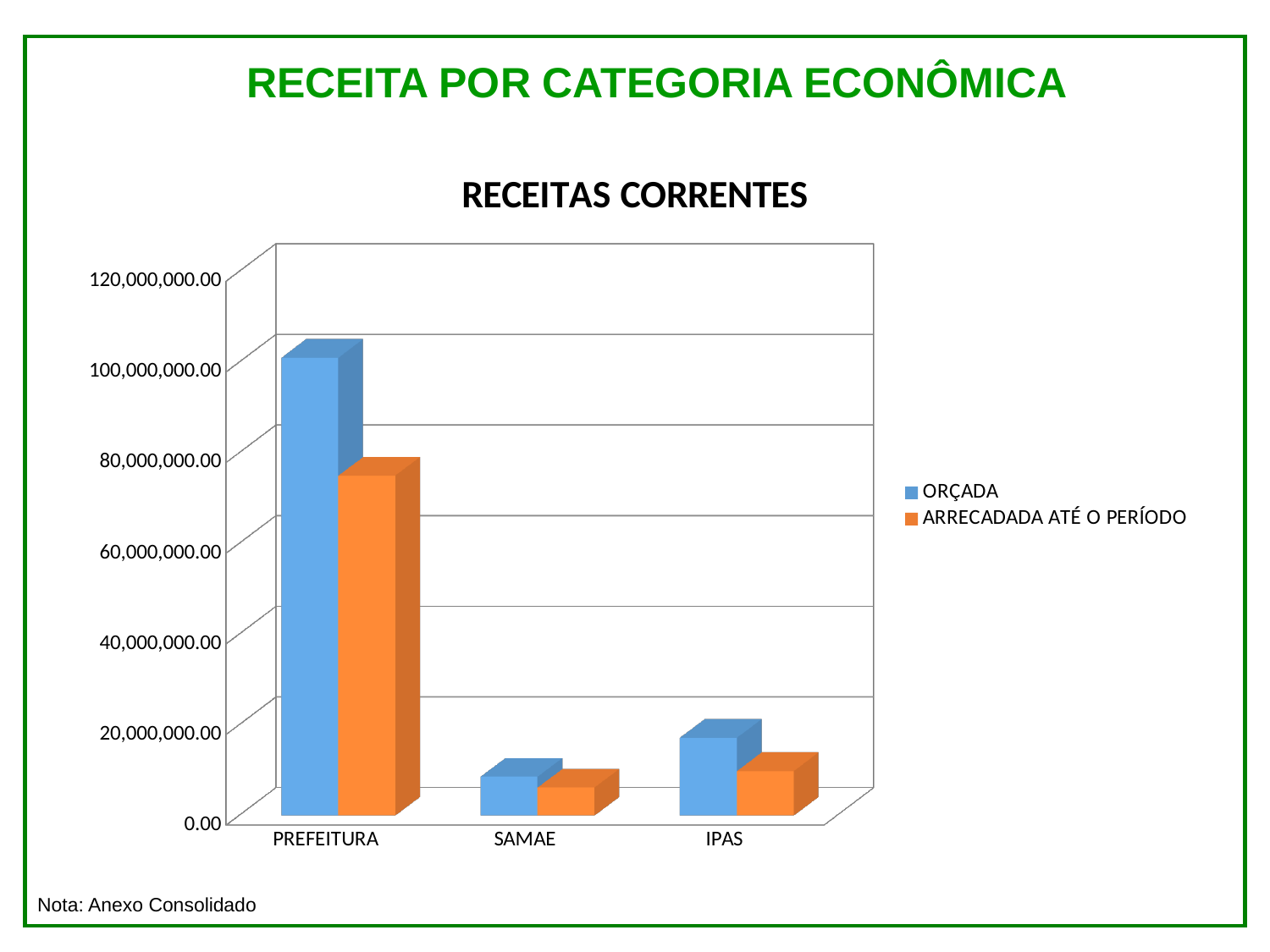
Which category has the highest ORÇADA value? PREFEITURA What kind of chart is shown on the slide? bar chart Is the ORÇADA value for PREFEITURA greater or less than 80,000,000.00? greater For PREFEITURA, which is larger: ORÇADA or ARRECADADA ATÉ O PERÍODO? ORÇADA Which has the larger ORÇADA value: SAMAE or IPAS? IPAS Which category has the lowest ARRECADADA ATÉ O PERÍODO value? SAMAE Is the ARRECADADA ATÉ O PERÍODO value for PREFEITURA greater or less than 60,000,000.00? greater Is the ORÇADA value for SAMAE greater or less than 20,000,000.00? less How many categories are shown on the x axis of the chart? 3 What is the title of the chart? RECEITAS CORRENTES Which category has the lowest ORÇADA value? SAMAE How many series does the chart's legend list? 2